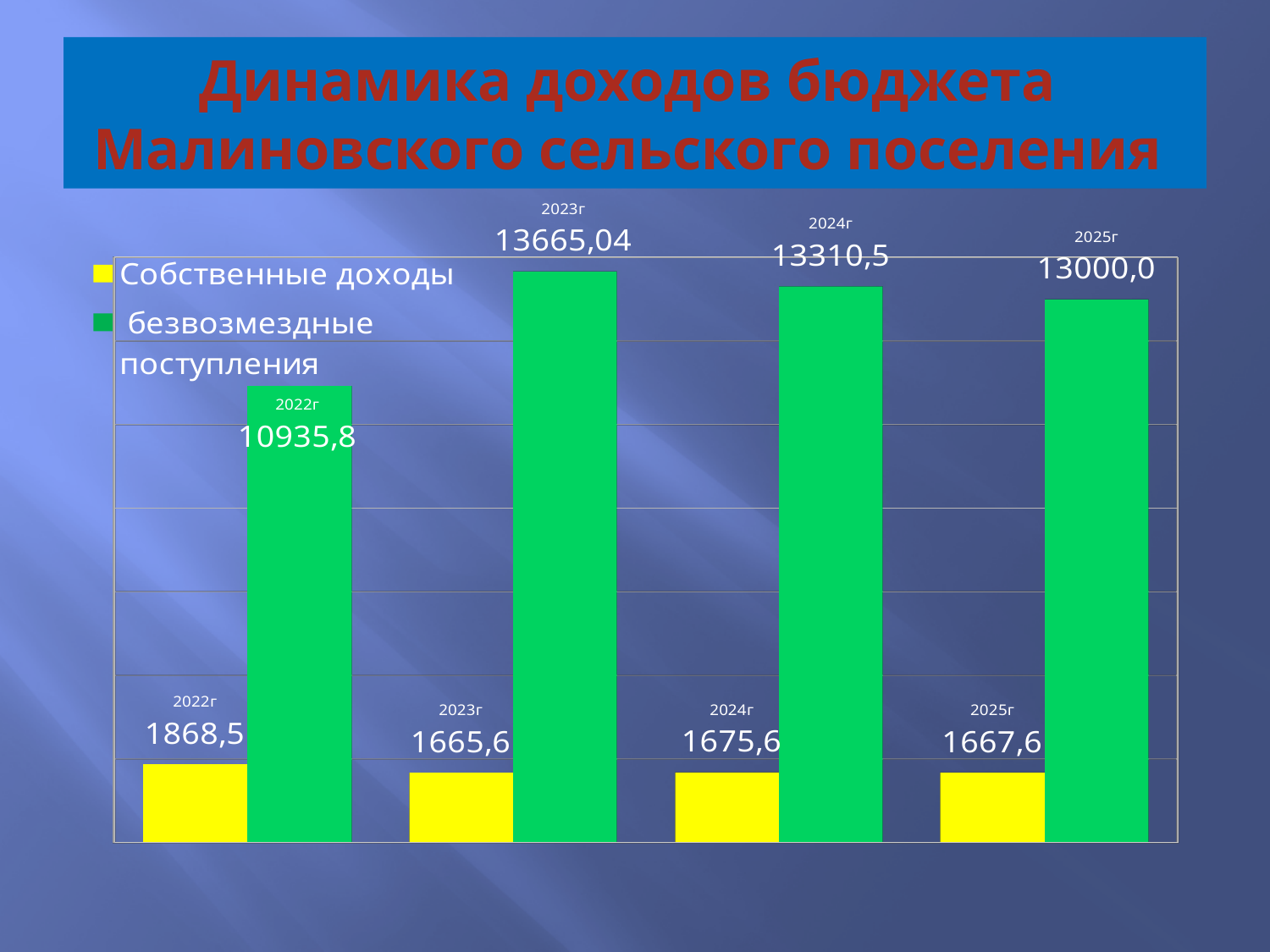
How many years are shown on the x axis? 4 In which year is Собственные доходы highest? 2022г What is the difference between безвозмездные поступления in 2024г and 2025г? 310,5 What is the value of безвозмездные поступления for 2023г? 13665,04 What type of chart is shown on the slide? bar chart Which is larger: Собственные доходы in 2024г or in 2023г? 2024г In which year is безвозмездные поступления highest? 2023г How many series does the legend list? 2 In which year is безвозмездные поступления lowest? 2022г Which colour represents Собственные доходы in the chart? yellow What is the value of Собственные доходы for 2022г? 1868,5 What is the value of безвозмездные поступления for 2025г? 13000,0